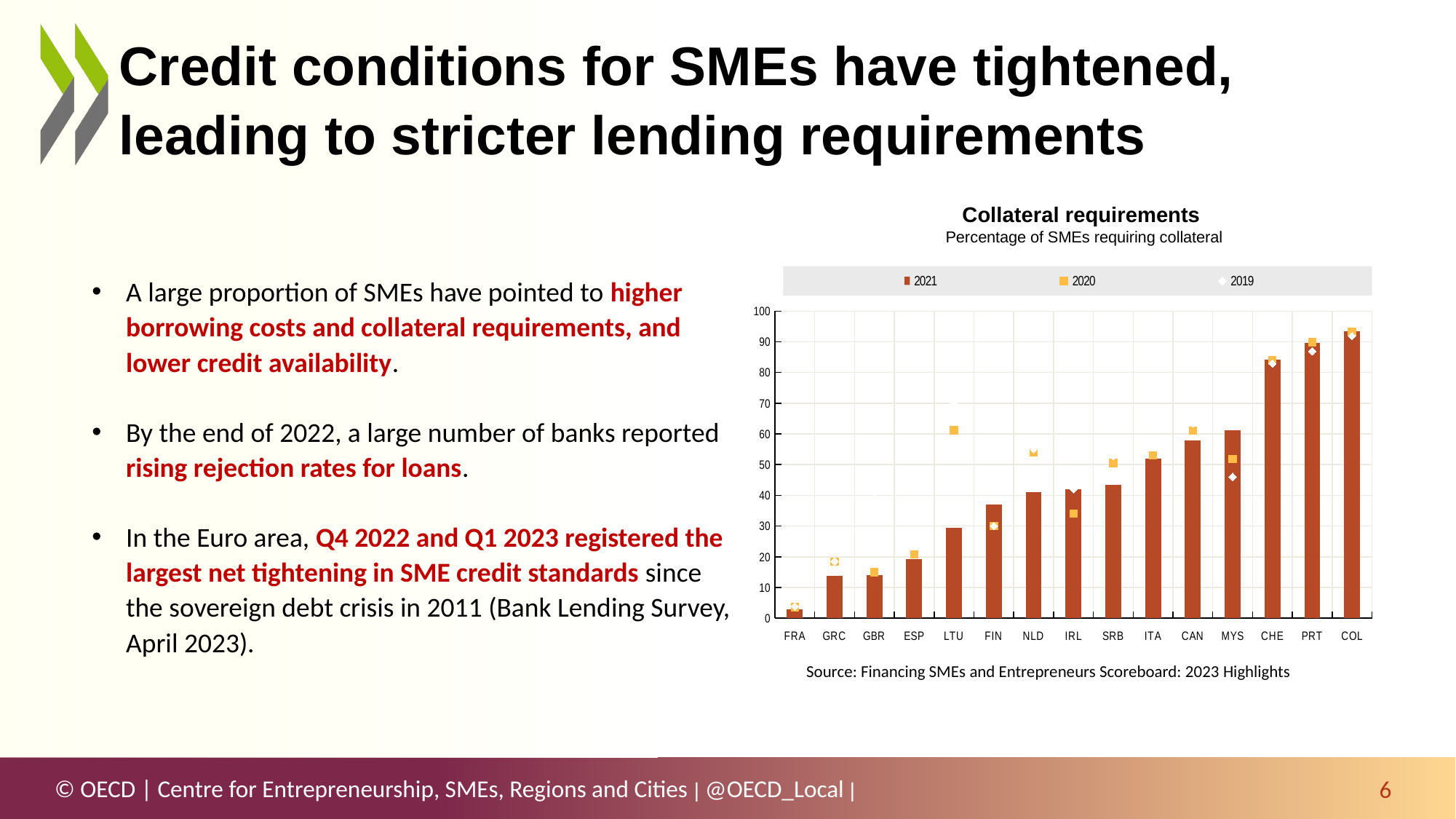
How many series does the legend of the Collateral requirements chart list? 3 Which country has the lowest 2021 bar in the Collateral requirements chart? FRA What is the subtitle shown under the chart title 'Collateral requirements'? Percentage of SMEs requiring collateral What kind of chart is shown on the slide? Bar chart Which country has the highest 2021 bar in the Collateral requirements chart? COL Is the 2021 value for FIN greater or less than 40? less Is the 2021 value for CHE greater or less than 80? greater Is the 2021 value for FRA greater or less than 10? less Which has the higher 2021 bar, CHE or PRT? PRT How many countries are shown on the x axis of the Collateral requirements chart? 15 Do the 2021 bars rise or fall from left to right along the x axis? Rise